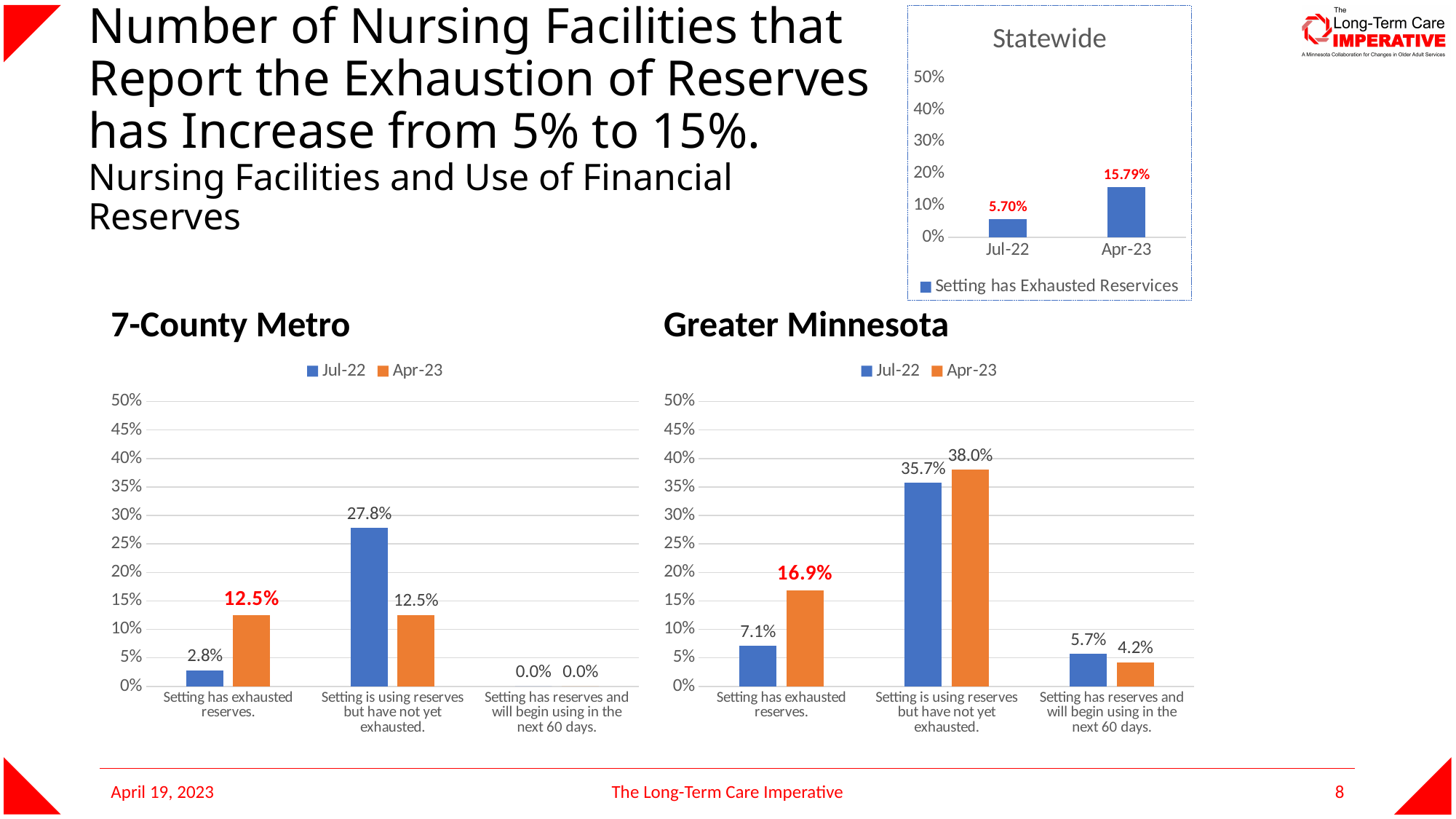
In the 7-County Metro chart, what is the difference between the Apr-23 and Jul-22 values for 'Setting has exhausted reserves'? 9.7% In the 7-County Metro chart, what is the Jul-22 value for 'Setting is using reserves but have not yet exhausted'? 27.8% In the 7-County Metro chart, which category has the highest Jul-22 value? Setting is using reserves but have not yet exhausted. In the Greater Minnesota chart, what is the Apr-23 value for 'Setting is using reserves but have not yet exhausted'? 38.0% In the 7-County Metro chart, what is the Apr-23 value for 'Setting has exhausted reserves'? 12.5% In the Greater Minnesota chart, which is larger for 'Setting has exhausted reserves': Jul-22 or Apr-23? Apr-23 In the Greater Minnesota chart, what is the Jul-22 value for 'Setting has reserves and will begin using in the next 60 days'? 5.7% In the Statewide chart, what is the difference between the Apr-23 and Jul-22 values? 10.09% In the Statewide chart, what is the value for Jul-22? 5.70% In the Statewide chart, what is the value for Apr-23? 15.79% How many series does the legend of the Greater Minnesota chart list? 2 What kind of chart is the 7-County Metro chart? Bar chart